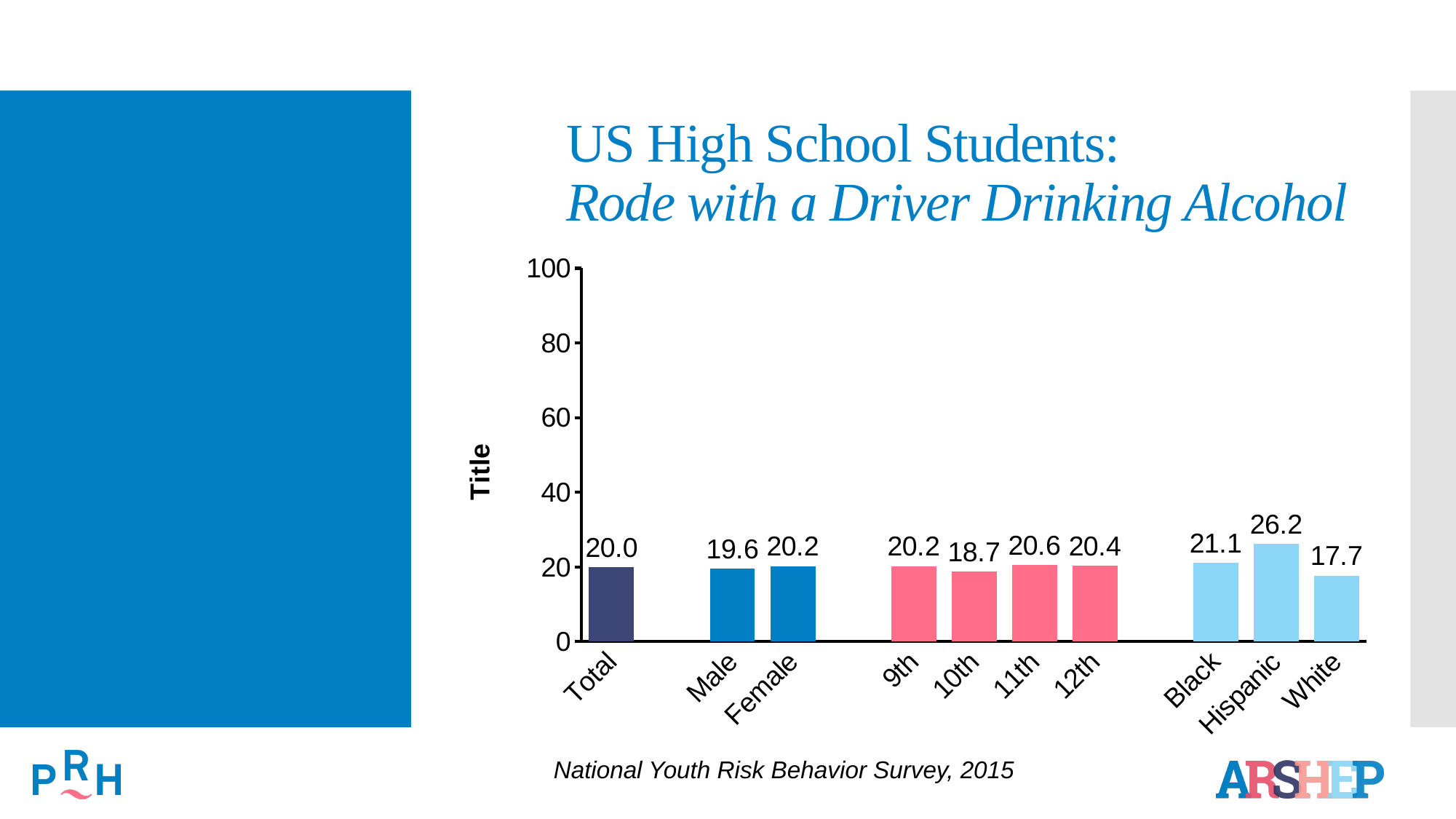
Which category has the highest value? Hispanic Which category has the lowest value? White Which is larger, the value for Black or the value for White? Black What is the value for 10th grade? 18.7 What is the value for Hispanic students? 26.2 What is the value for Total? 20.0 What is the source cited below the chart? National Youth Risk Behavior Survey, 2015 What kind of chart is shown on the slide? Bar chart How many bars are shown in the chart? 10 What is the difference between the Hispanic and White values? 8.5 Is the value for Hispanic greater or less than 20? greater What is the difference between the Female and Male values? 0.6